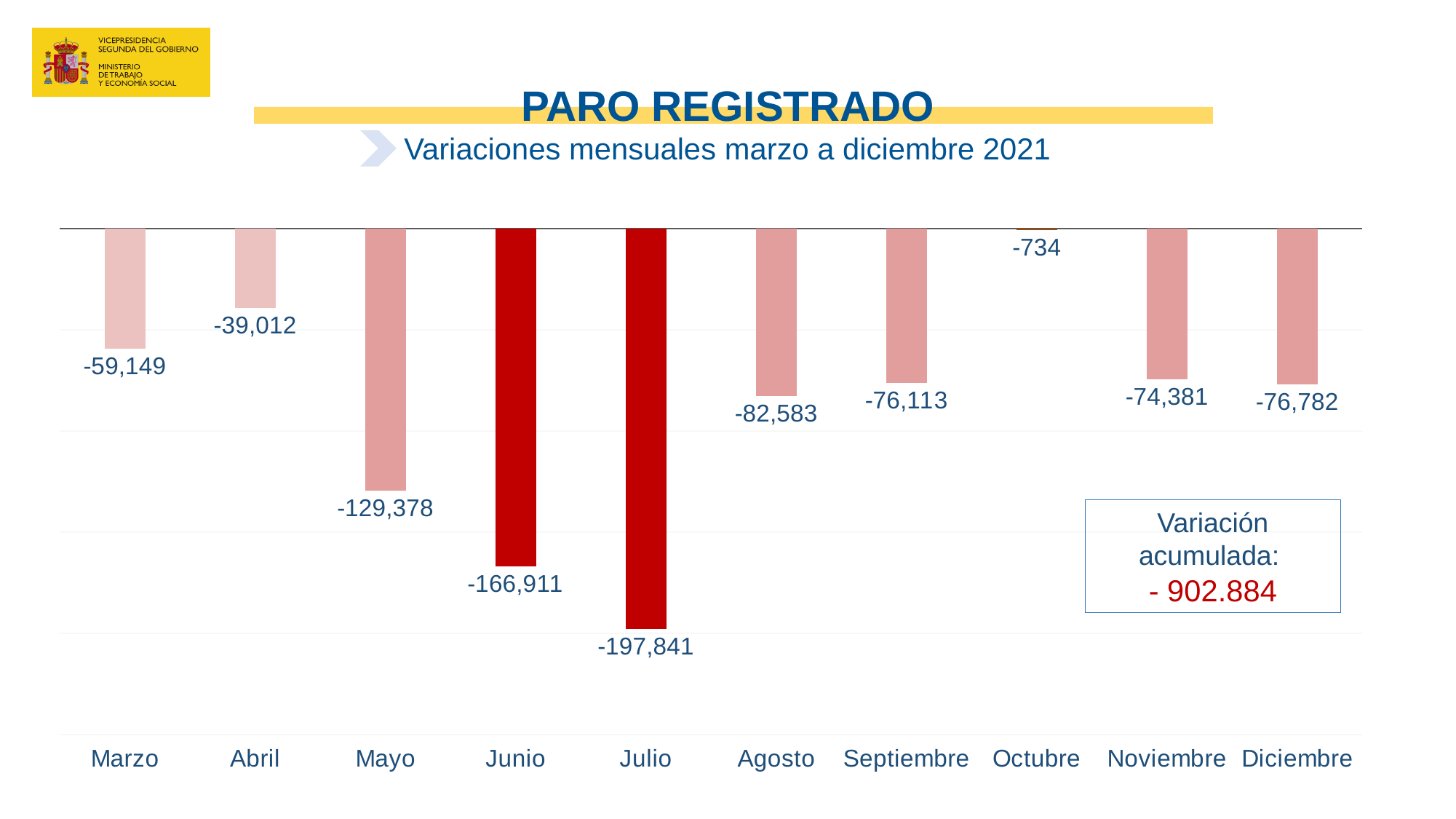
Which month shows a larger decrease, Agosto or Septiembre? Agosto What kind of chart is shown on the slide? Bar chart What accumulated variation (Variación acumulada) is shown in the box on the chart? - 902.884 What is the value shown for Julio? -197,841 Which month has the highest (least negative) value? Octubre What is the value shown for Octubre? -734 How many months are plotted on the chart? 10 What is the value shown for Mayo? -129,378 What is the difference between the values for Marzo and Abril? 20,137 Which month has the lowest (most negative) value? Julio What is the difference between the values for Julio and Junio? 30,930